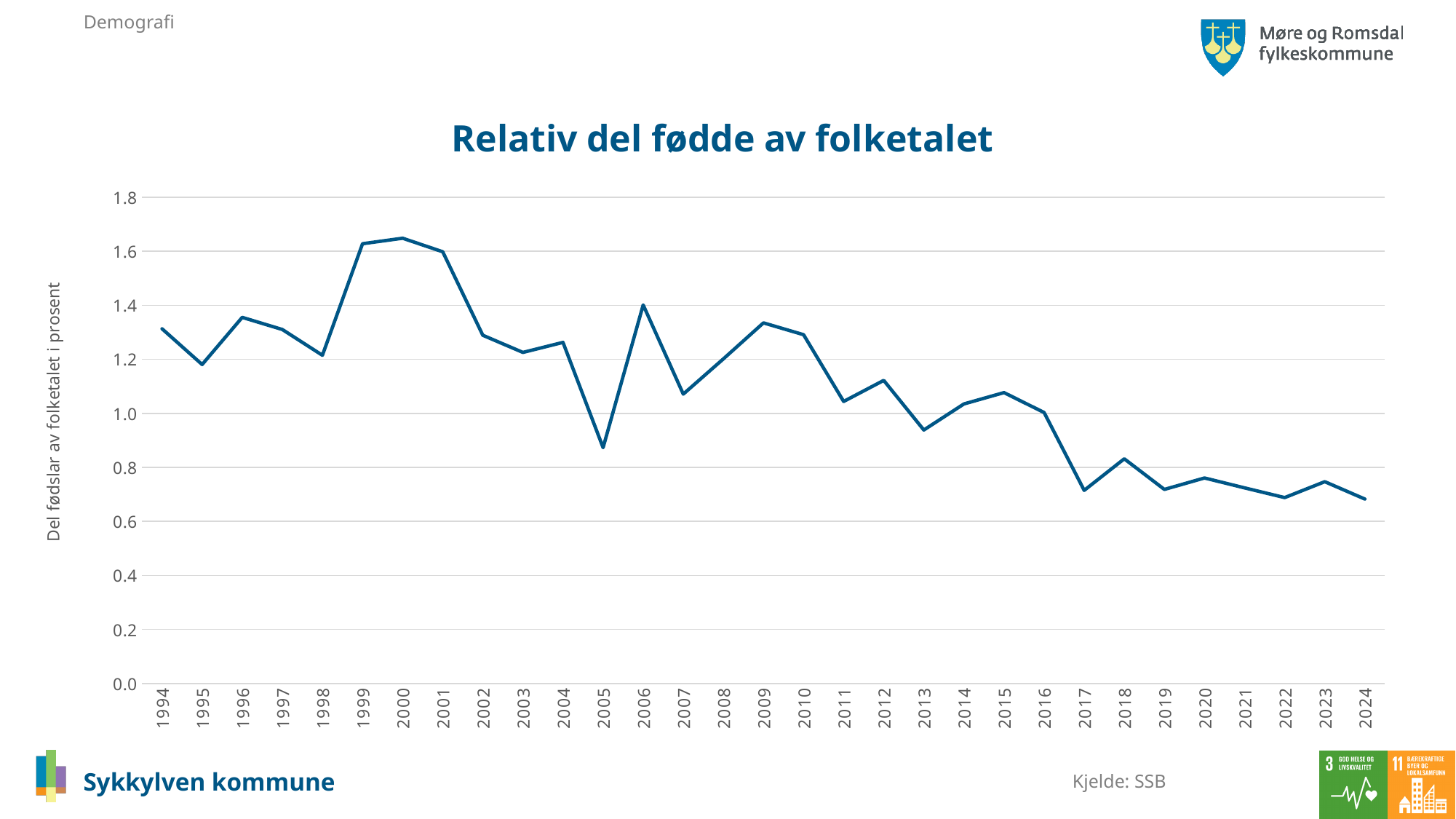
What kind of chart is shown on the slide? line chart Which year has the larger value, 2000 or 2024? 2000 Is the value for 1999 greater or less than 1.4? greater Is the value for 2017 greater or less than 0.8? less Overall, do the values rise or fall from 1994 to 2024? fall How many years are plotted along the x axis of the chart? 31 Which year has the larger value, 2006 or 2007? 2006 What is the label on the vertical axis of the chart? Del fødslar av folketalet i prosent Is the value for 2006 greater or less than 1.2? greater What is the title of the chart? Relativ del fødde av folketalet